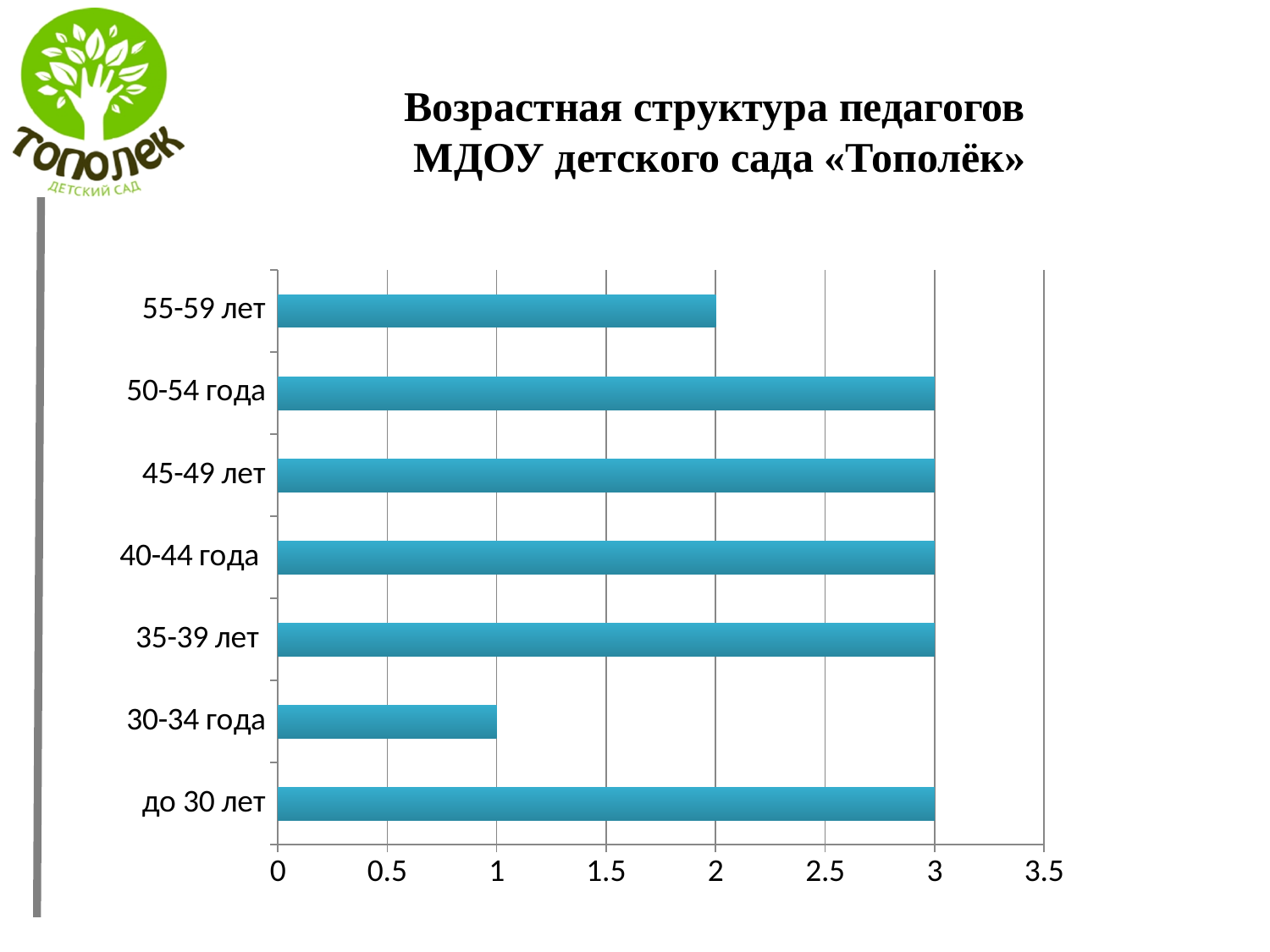
What is the value for the до 30 лет category? 3 What is the difference between the values for 50-54 года and 55-59 лет? 1 What is the value for the 45-49 лет category? 3 How many age categories are shown in the chart? 7 Is the value for 55-59 лет greater or less than 2.5? less Which category has the lowest value? 30-34 года What is the title of the chart on the slide? Возрастная структура педагогов МДОУ детского сада «Тополёк» What is the value for the 55-59 лет category? 2 What kind of chart is shown on the slide? bar chart What is the value for the 30-34 года category? 1 What is the difference between the values for 35-39 лет and 30-34 года? 2 Which is larger, the value for 55-59 лет or the value for 30-34 года? 55-59 лет